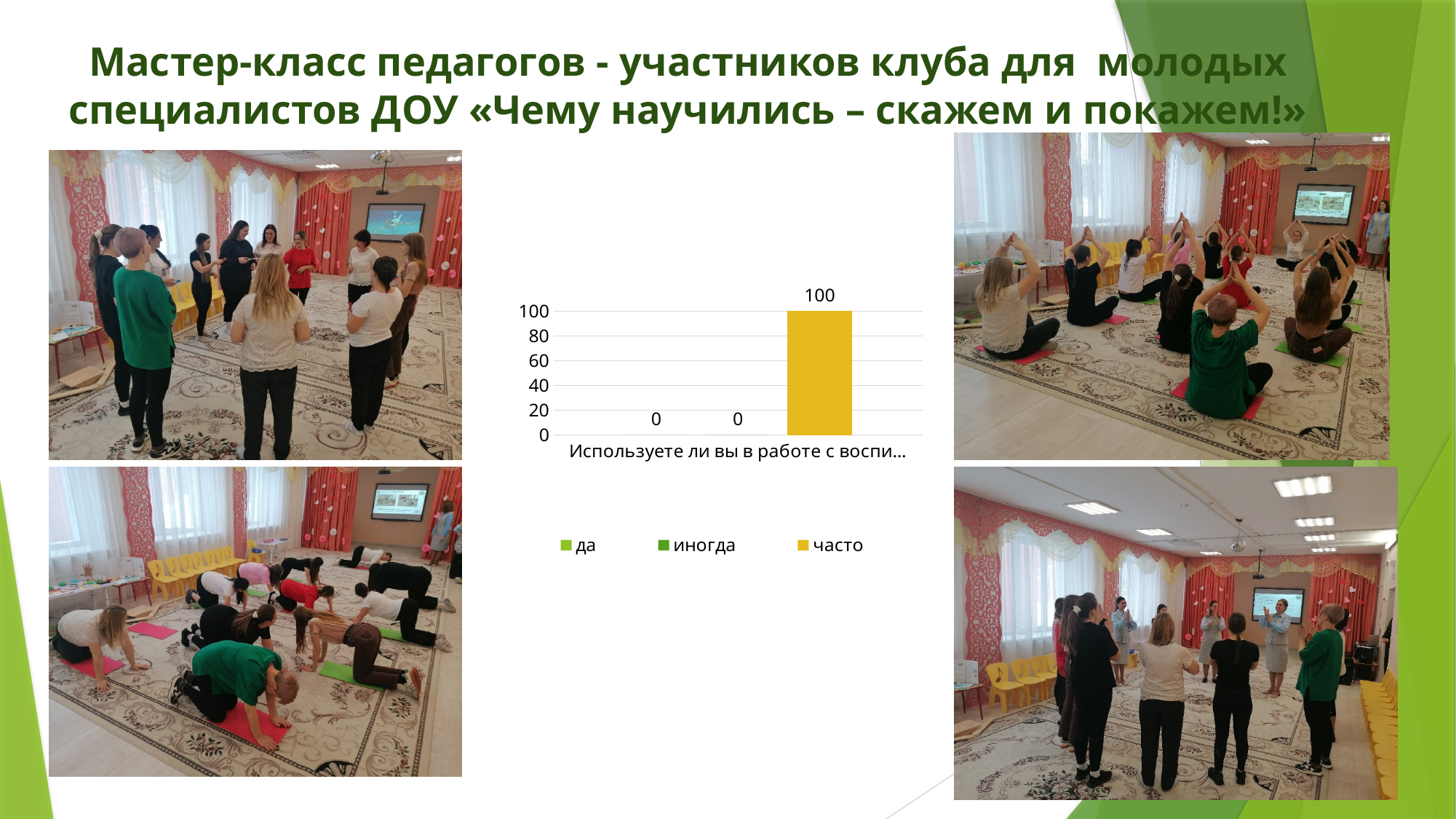
What kind of chart is shown on the slide? bar chart What is the value for the series "иногда"? 0 What is the value for the series "часто"? 100 What is the highest value shown on the chart's vertical axis? 100 Is the value for "часто" greater or less than 80? greater How many series does the chart legend list? 3 What is the value for the series "да"? 0 Which is larger, the value for "часто" or the value for "иногда"? часто What is the difference between the values for "часто" and "да"? 100 What colour is the bar for the series "часто"? yellow How many categories are shown on the x axis of the chart? 1 Which series has the highest value? часто